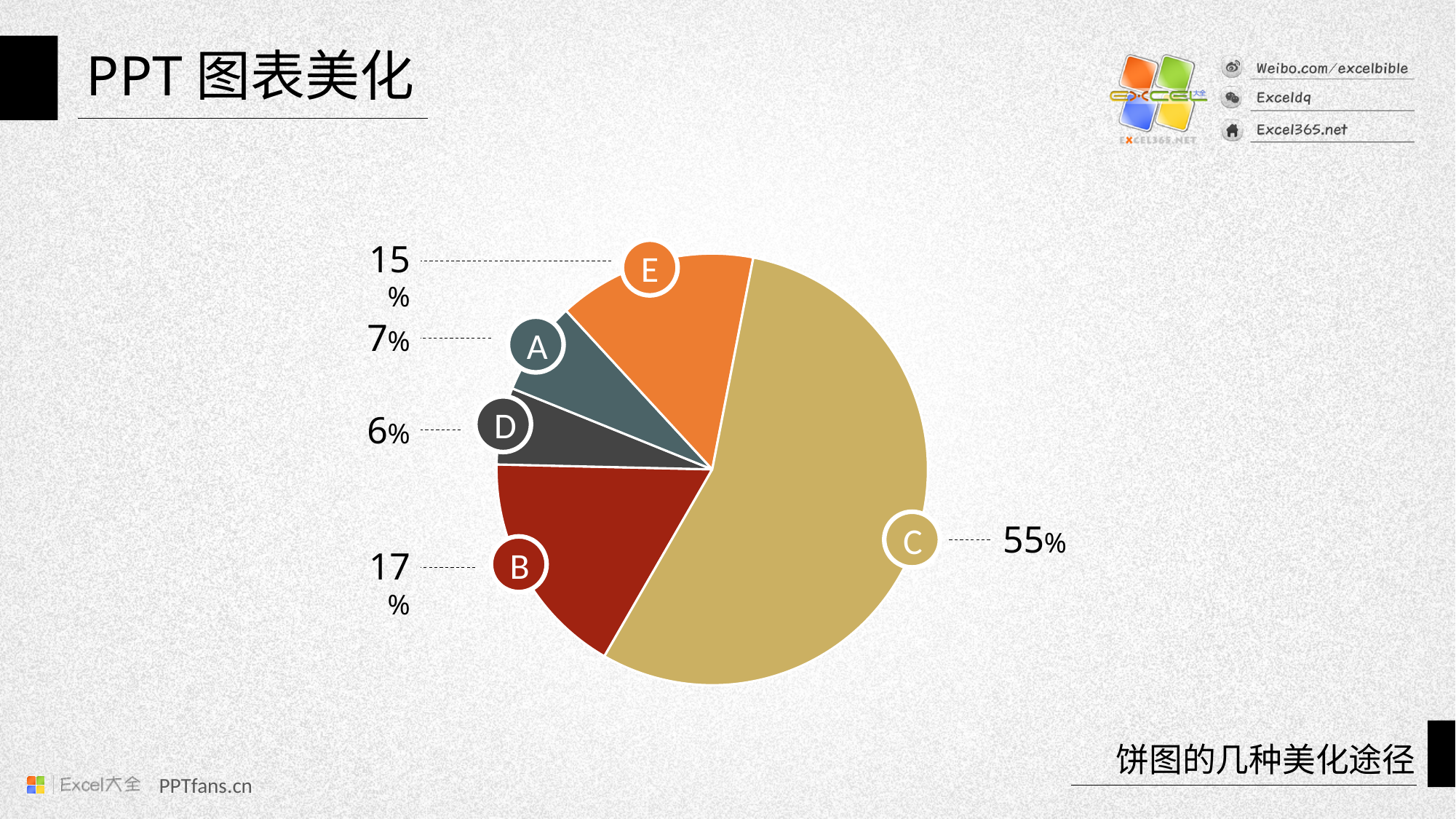
What kind of chart is shown on the slide? pie chart What is the value for slice B? 17% What is the value for slice C? 55% What colour is slice C? gold What is the value for slice D? 6% Which is larger, the value for E or the value for A? E Which slice is the largest? C How many slices does the pie chart have? 5 What is the difference between the values for C and B? 38% What is the value for slice E? 15% What is the value for slice A? 7% Which slice is the smallest? D